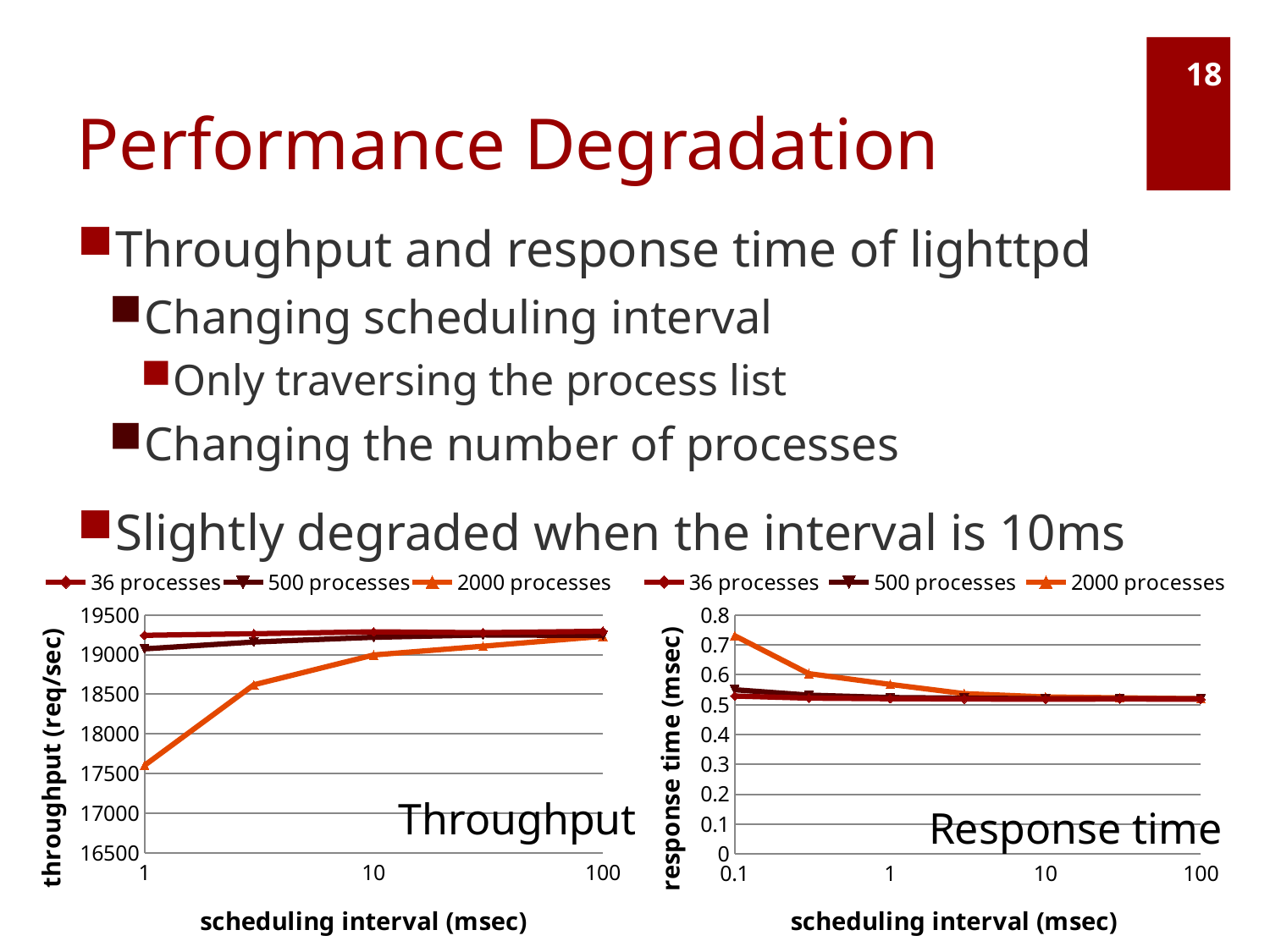
What kind of chart is the Throughput chart? line chart In the Response time chart, which series has the highest response time at a scheduling interval of 0.1 msec? 2000 processes In the Throughput chart, which series has the lowest throughput at a scheduling interval of 1 msec? 2000 processes In the Throughput chart, does the 2000 processes series rise or fall as the scheduling interval increases? rise In the Response time chart, is the value for 2000 processes at a scheduling interval of 0.1 msec greater or less than 0.7? greater What is the y-axis label of the Response time chart? response time (msec) What are the legend entries of the Throughput chart? 36 processes, 500 processes, 2000 processes In the Throughput chart, is the value for 2000 processes at a scheduling interval of 1 msec greater or less than 18000? less In the Throughput chart, is the value for 36 processes at a scheduling interval of 1 msec greater or less than 19000? greater In the Response time chart, does the 2000 processes series rise or fall as the scheduling interval increases? fall In the Throughput chart, at a scheduling interval of 1 msec, which is larger: the value for 36 processes or the value for 2000 processes? 36 processes How many series does the legend of the Response time chart list? 3